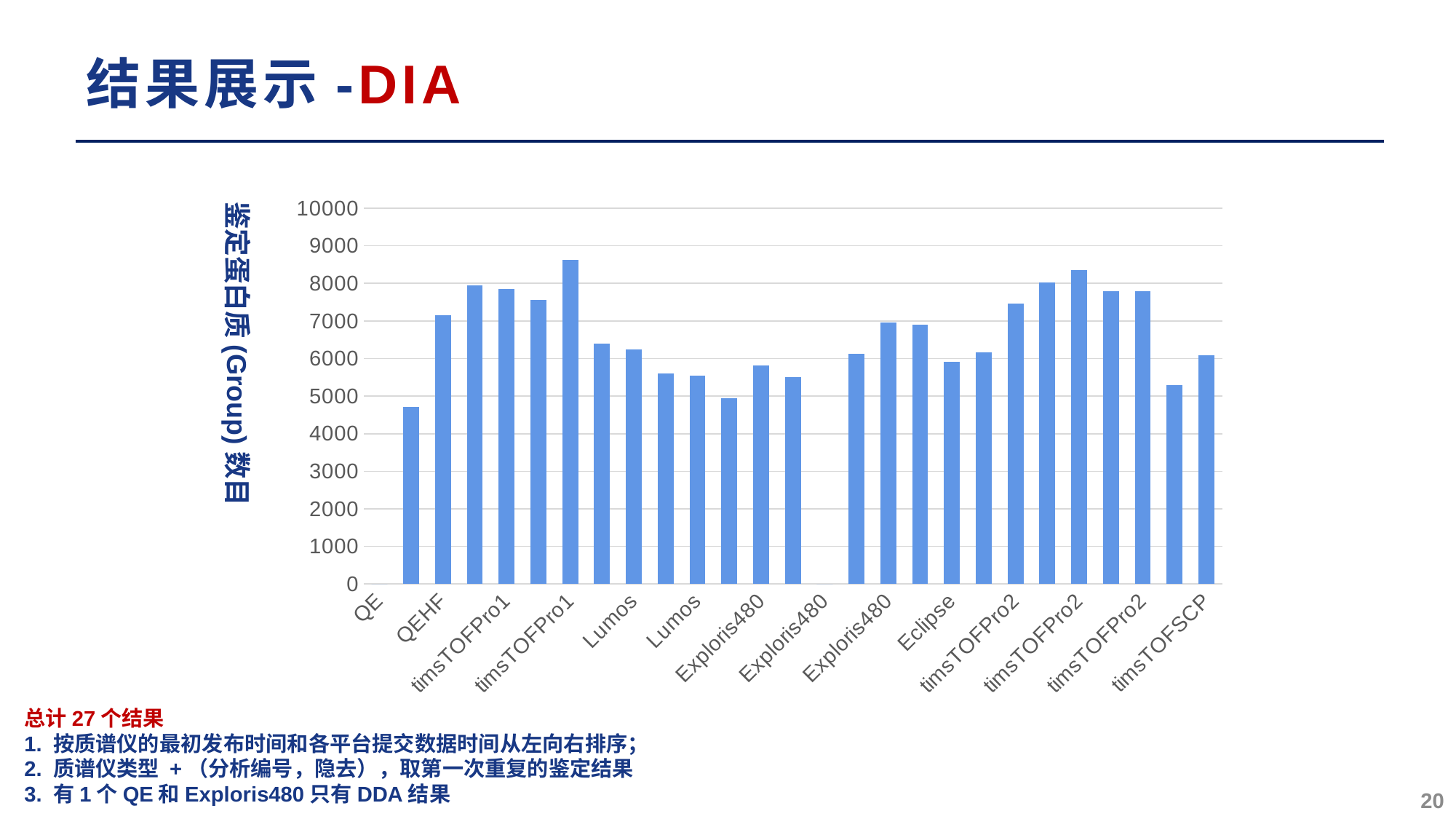
What is the highest value shown on the y axis of the chart? 10000 Is the value for QE (the leftmost bar) greater or less than 5000? less Do any bars in the chart reach 9000? No Which instrument group contains the tallest bar in the chart? timsTOFPro1 What kind of chart is shown on the slide? bar chart Is the tallest bar in the chart greater or less than 8000? greater Which is larger, the bar for QE or the bar for QEHF? QEHF What is the title of the y axis of the chart? 鉴定蛋白质(Group)数目 Which is larger, the leftmost bar (QE) or the rightmost bar (timsTOFSCP)? timsTOFSCP